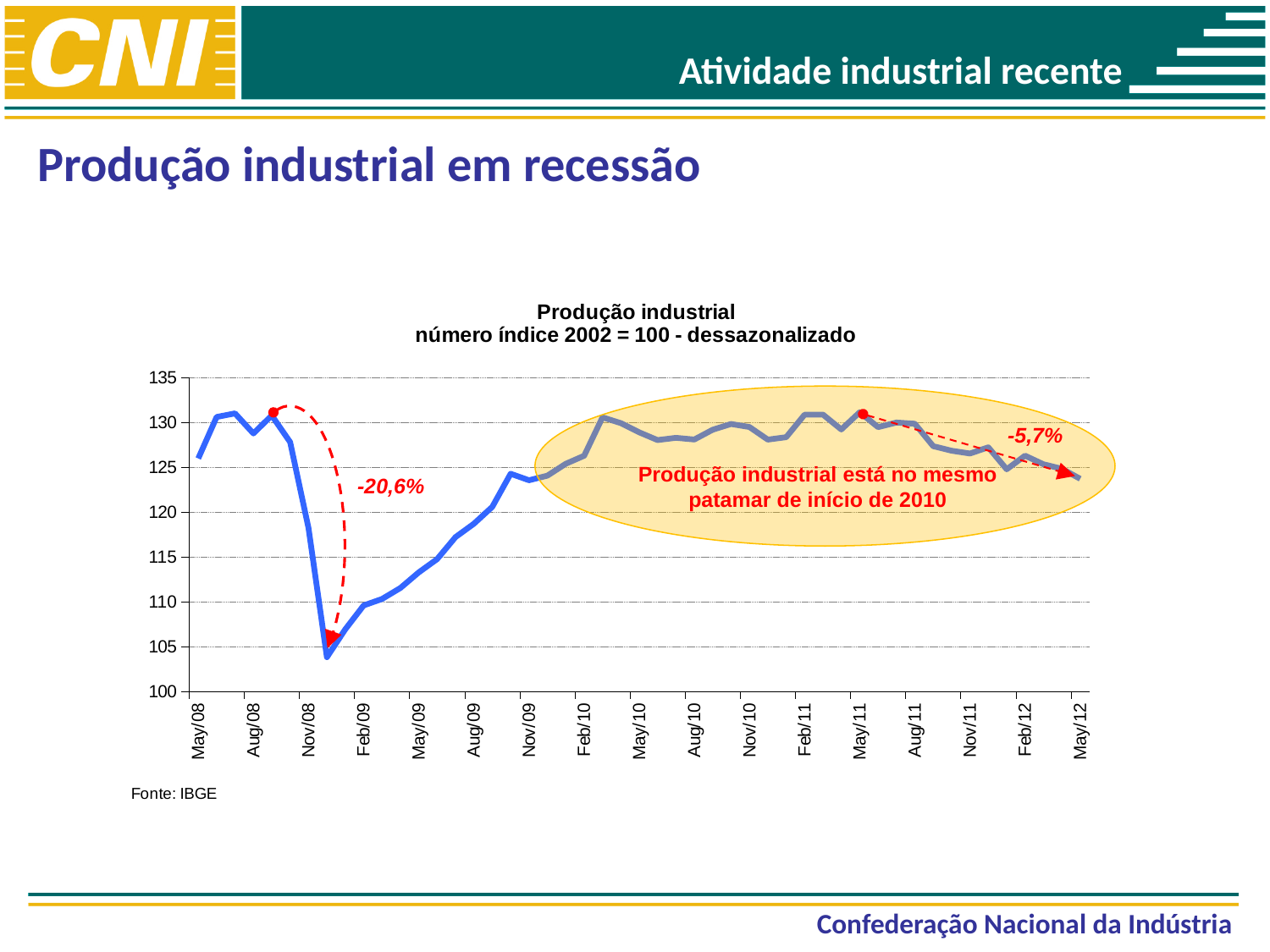
Is the value for Feb/10 greater or less than 125? greater Which is larger, the value for Feb/10 or the value for May/09? Feb/10 Is the value for Aug/09 greater or less than 125? less Does the index rise or fall between May/11 and May/12? fall What is the title of the chart? Produção industrial número índice 2002 = 100 - dessazonalizado How many month labels are shown on the x axis? 17 Is the value for May/12 greater or less than 130? less What kind of chart is shown on the slide? line chart What source is cited below the chart? IBGE Does the index rise or fall between Feb/09 and Feb/10? rise